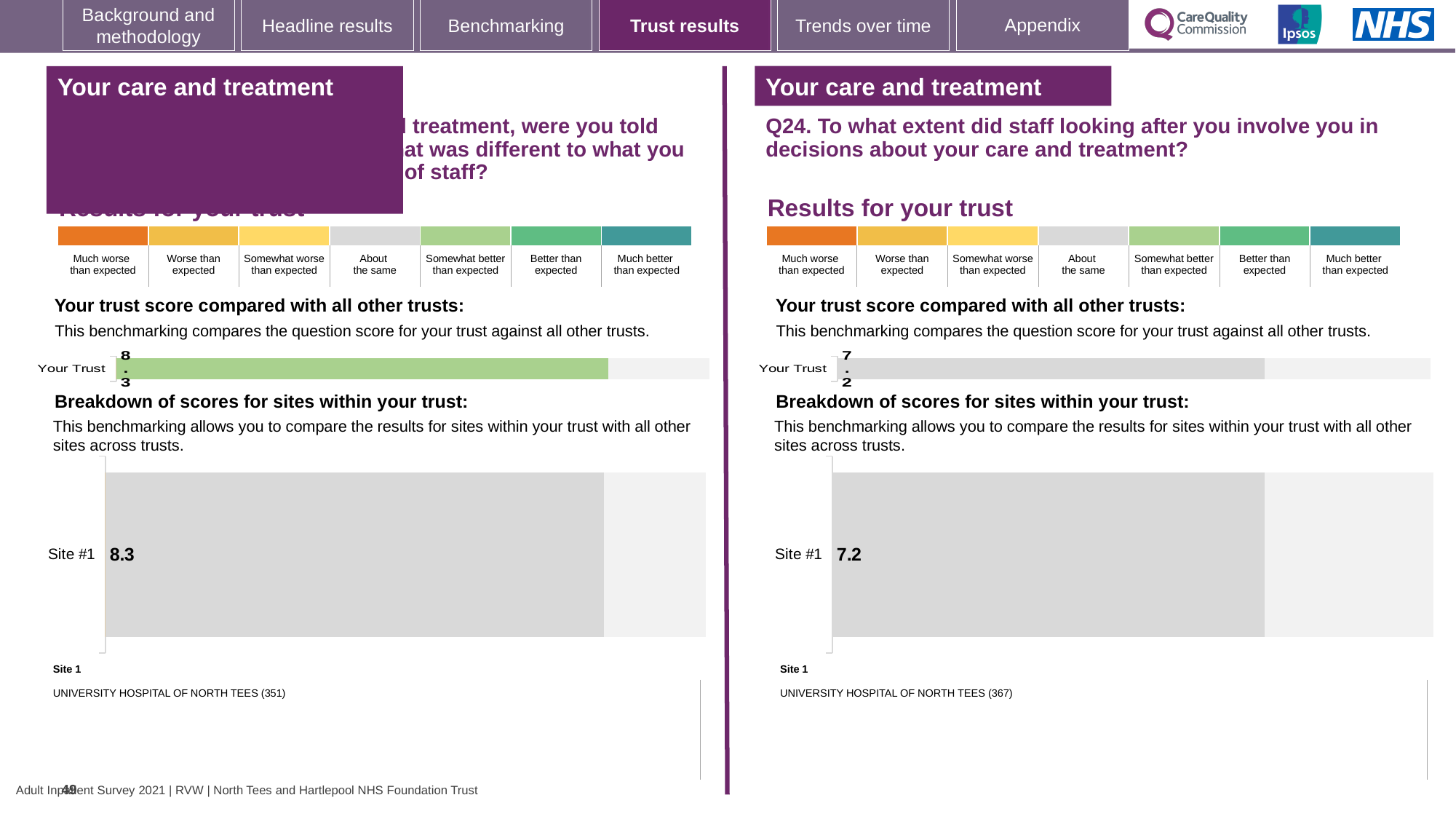
Which is larger: the 'Your Trust' score on the left half of the slide or the 'Your Trust' score for Q24 on the right? The left half (8.3) What type of chart is used to show the 'Your Trust' score on each half of the slide? Bar chart In the site breakdown chart on the left half of the slide, what is the score for Site #1? 8.3 What colour is the 'Your Trust' bar for Q24 on the right half of the slide? Grey On the left half of the slide, what is the 'Your Trust' score shown in the trust benchmarking bar? 8.3 Which site is listed as Site 1 in the Q24 breakdown on the right half of the slide? UNIVERSITY HOSPITAL OF NORTH TEES (367) What colour is the 'Your Trust' bar on the left half of the slide? Light green Is the 'Your Trust' score for Q24 on the right half of the slide greater or less than 8? less What is the difference between the Site #1 score on the left half of the slide and the Site #1 score for Q24 on the right? 1.1 In the Q24 site breakdown chart on the right, what is the score for Site #1? 7.2 On the right half of the slide (Q24), what is the 'Your Trust' score shown in the trust benchmarking bar? 7.2 How many sites are shown in the Q24 site breakdown chart on the right? 1